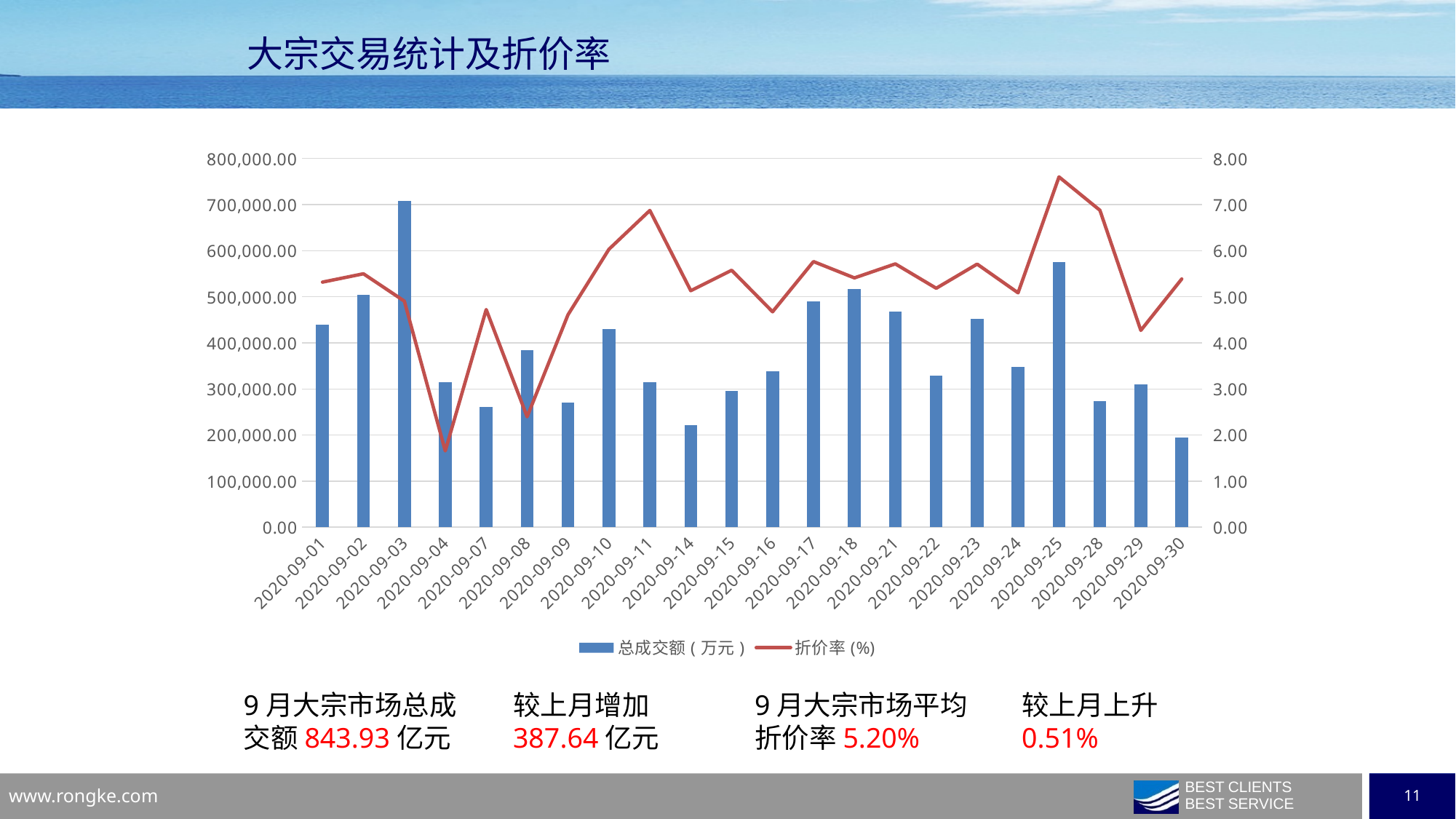
How many dates are shown on the x axis? 22 What kind of chart is shown on the slide? A combined bar and line chart How many series does the legend list? 2 On which date is the 总成交额 bar the highest? 2020-09-03 Which date has the larger 总成交额 bar, 2020-09-02 or 2020-09-04? 2020-09-02 Is the 总成交额 value for 2020-09-03 greater or less than 600,000.00? greater On which date does the 折价率 line reach its lowest point? 2020-09-04 What are the two entries in the chart legend? 总成交额（万元） and 折价率 (%) Is the 折价率 value for 2020-09-25 greater or less than 7.00? greater On which date does the 折价率 line reach its highest point? 2020-09-25 On which date is the 总成交额 bar the lowest? 2020-09-30 Is the 总成交额 value for 2020-09-14 greater or less than 300,000.00? less